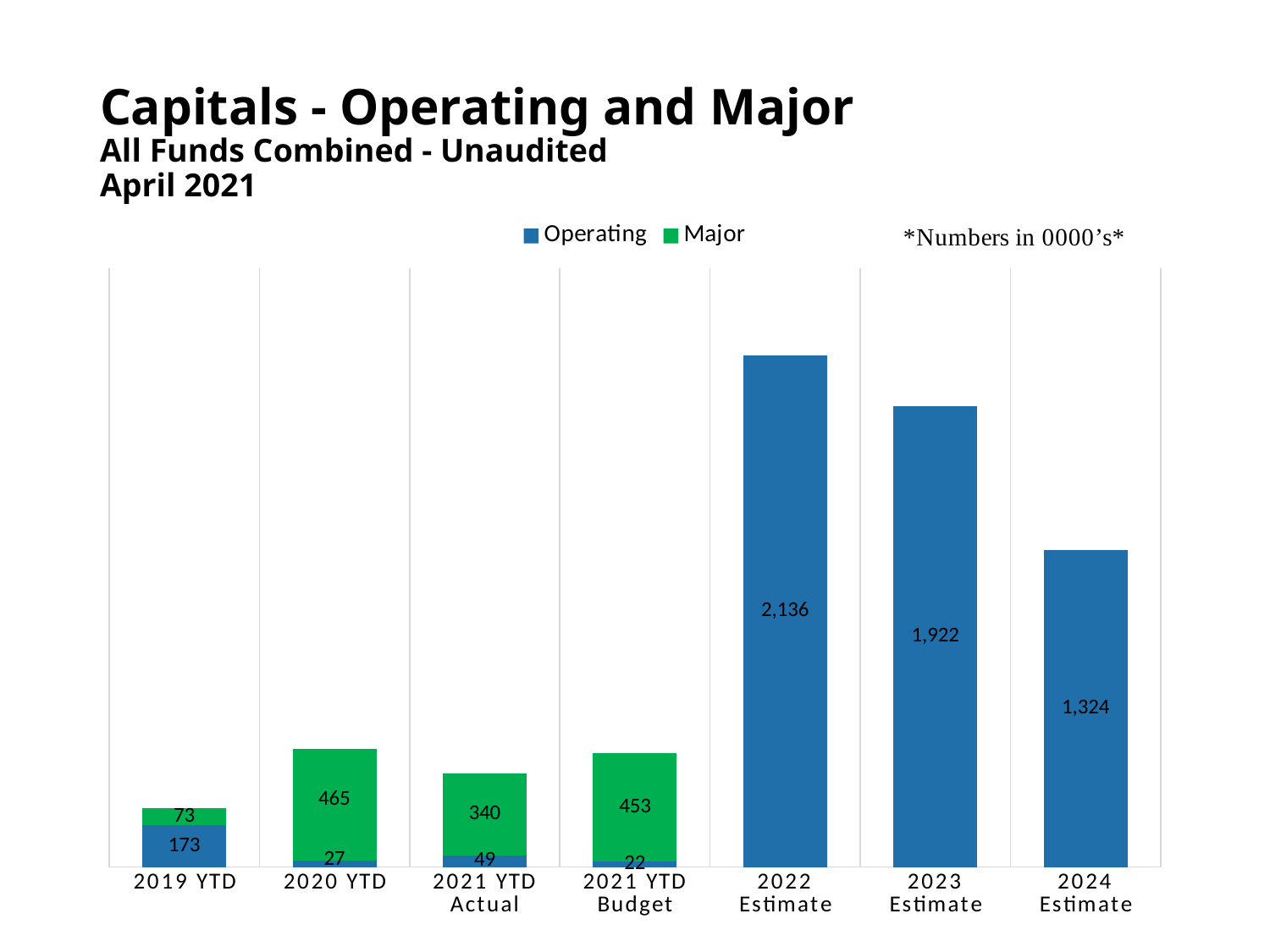
What is the Operating value for 2023 Estimate? 1,922 What is the total of the stacked bar for 2019 YTD? 246 Which category has the highest Operating value? 2022 Estimate Which is larger, the Major value for 2021 YTD Actual or the Major value for 2021 YTD Budget? 2021 YTD Budget What is the difference between the Operating values for 2022 Estimate and 2024 Estimate? 812 How many series does the legend list? 2 What is the Major value for 2021 YTD Budget? 453 What is the Operating value for 2021 YTD Actual? 49 Which category has the lowest Operating value? 2021 YTD Budget How many categories are shown on the x axis? 7 What is the Major value for 2020 YTD? 465 What is the Operating value for 2019 YTD? 173